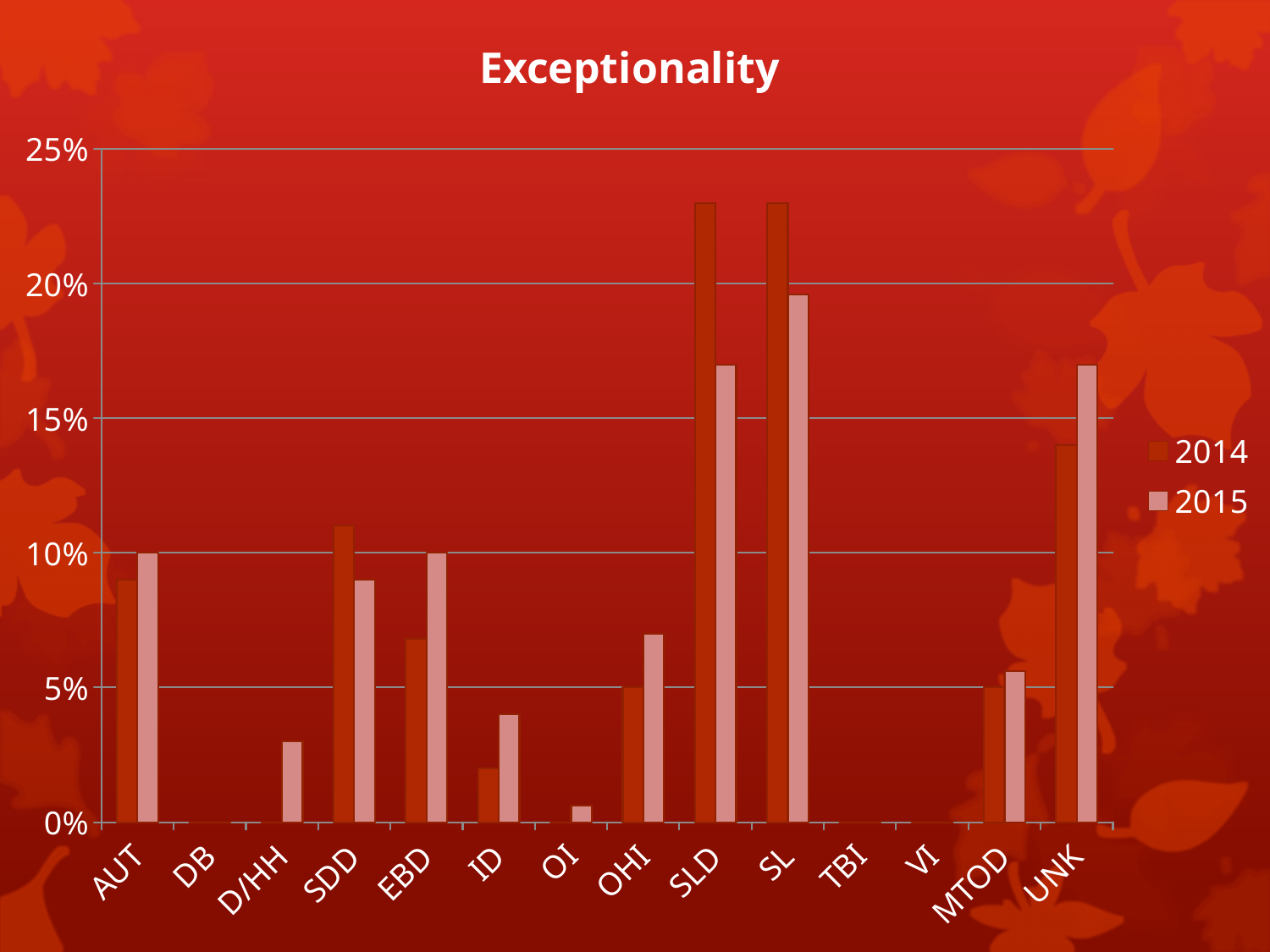
How many series does the legend list? 2 How many categories are shown on the x axis? 14 Is the 2015 value for ID greater or less than 5%? less Is the 2014 value for SLD greater or less than 20%? greater For 2015, which is larger: SL or SLD? SL What is the title of the chart? Exceptionality What kind of chart is shown on the slide? bar chart Is the 2014 value for AUT greater or less than 10%? less For SDD, which year has the larger value, 2014 or 2015? 2014 For UNK, which year has the larger value, 2014 or 2015? 2015 Which two series are listed in the legend? 2014 and 2015